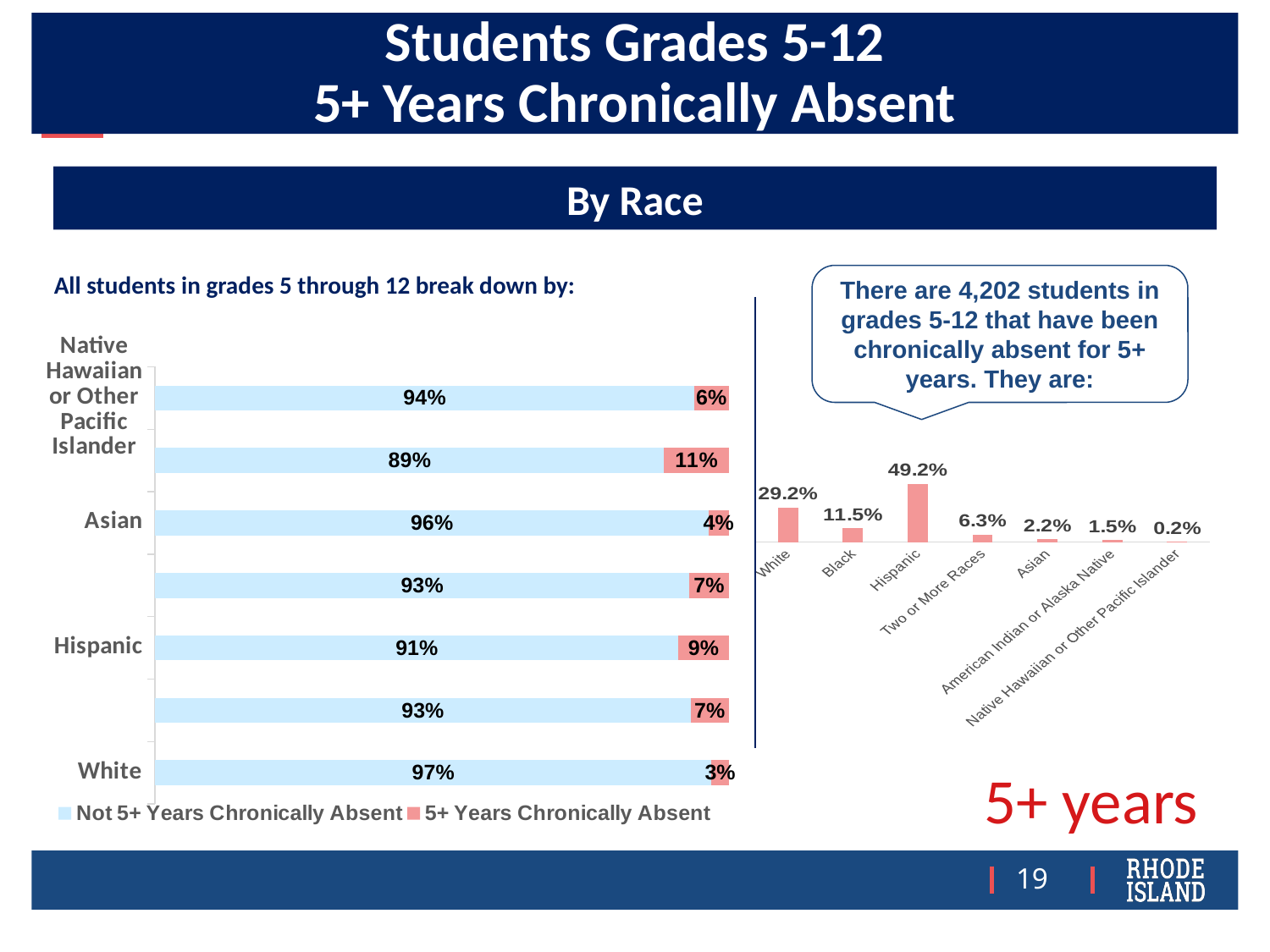
In the right-hand chart, what is the difference between the values for Hispanic and White? 20 percentage points In the right-hand chart, what is the value for Black? 11.5% How many race categories are shown in the right-hand chart? 7 In the right-hand chart, which race has the lowest value? Native Hawaiian or Other Pacific Islander In the right-hand chart, what percentage of the 4,202 chronically absent students are Hispanic? 49.2% In the left-hand chart, what percentage of Asian students are 5+ years chronically absent? 4% In the right-hand chart, which race has the highest share of students chronically absent for 5+ years? Hispanic In the right-hand chart, which is larger, the value for Two or More Races or the value for Asian? Two or More Races How many series does the legend of the left-hand chart list? 2 What type of chart is the left-hand chart? Stacked bar chart In the left-hand chart, what percentage of White students are 5+ years chronically absent? 3% In the left-hand chart, what percentage of Hispanic students are not 5+ years chronically absent? 91%